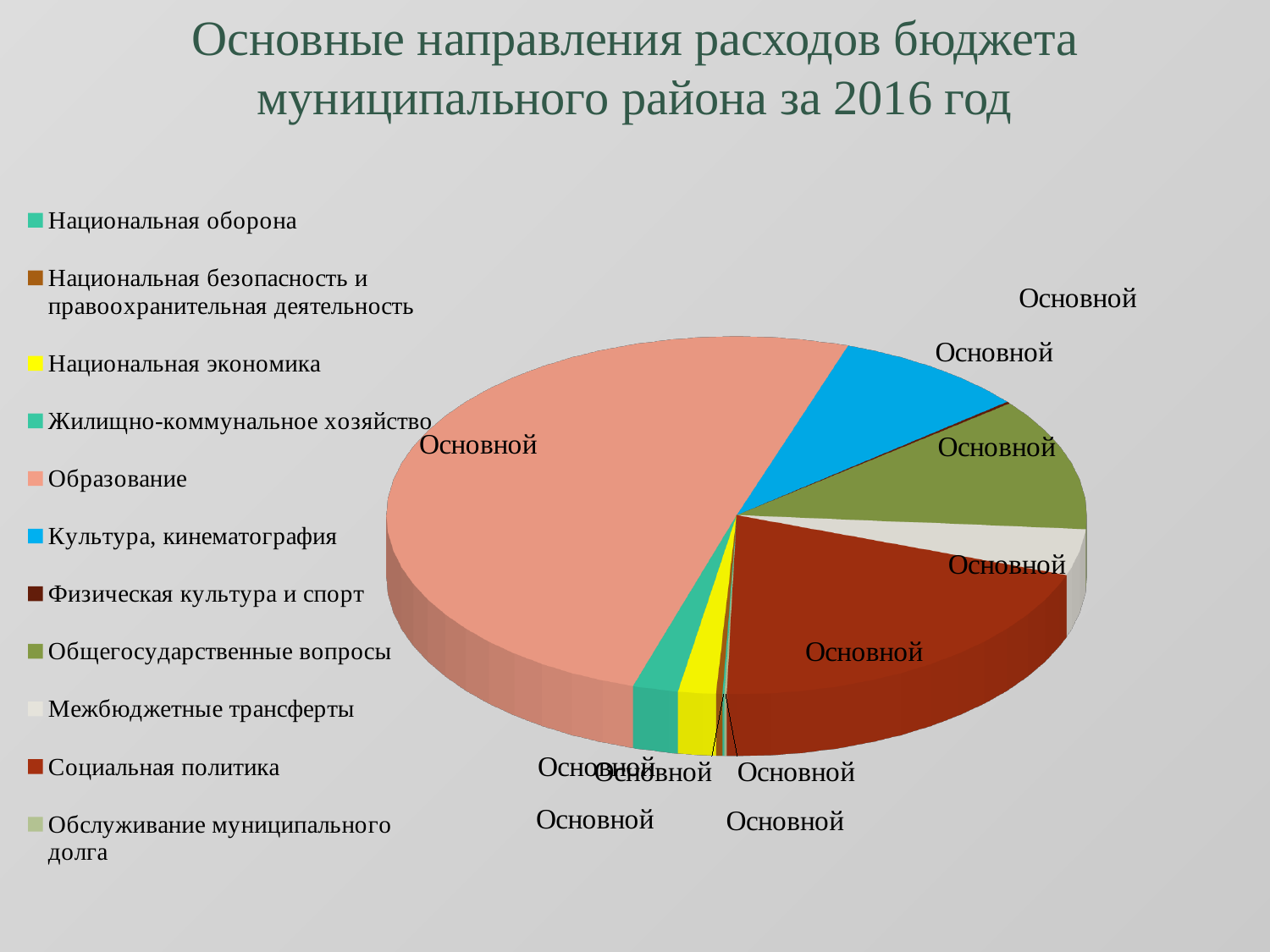
Which category has the largest slice of the pie chart? Образование Which slice is larger: Образование or Социальная политика? Образование Which slice is larger: Социальная политика or Межбюджетные трансферты? Социальная политика Which slice is larger: Культура, кинематография or Жилищно-коммунальное хозяйство? Культура, кинематография What is the title of the slide containing the pie chart? Основные направления расходов бюджета муниципального района за 2016 год What kind of chart is shown on the slide? pie chart What colour is the Образование slice in the pie chart? light salmon pink How many categories does the legend of the pie chart list? 11